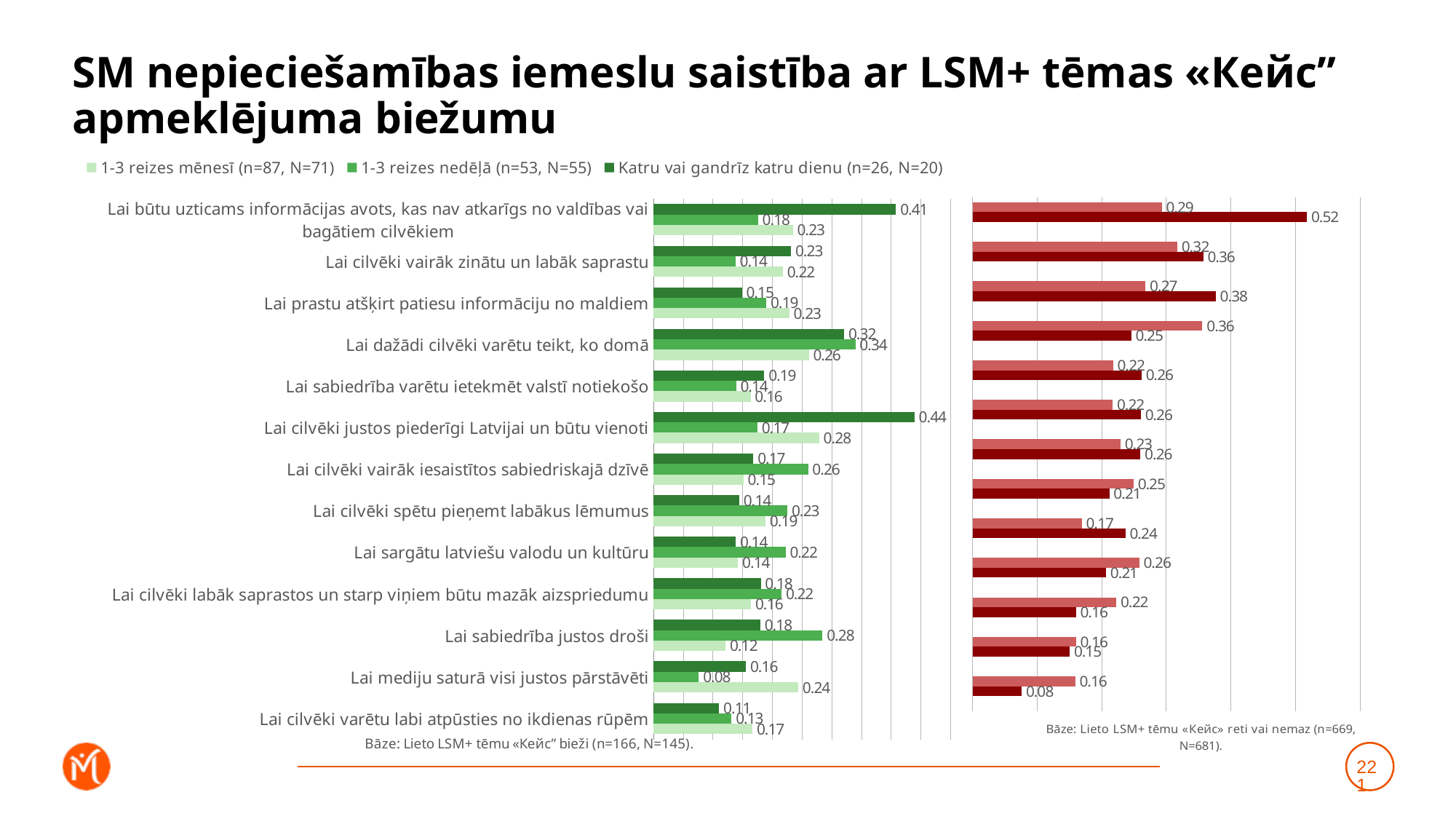
In the left chart, for 'Lai sabiedrība justos droši', which is larger: the '1-3 reizes nedēļā' value or the '1-3 reizes mēnesī' value? 1-3 reizes nedēļā In the left chart, what is the value for 'Katru vai gandrīz katru dienu' for 'Lai cilvēki justos piederīgi Latvijai un būtu vienoti'? 0.44 In the left chart, which category has the lowest value for the '1-3 reizes nedēļā' series? Lai mediju saturā visi justos pārstāvēti How many categories are shown in the left chart? 13 In the left chart, what is the value for '1-3 reizes mēnesī' for 'Lai mediju saturā visi justos pārstāvēti'? 0.24 How many series does the legend of the left chart list? 3 What kind of chart is the left chart? Bar chart In the left chart, for 'Lai būtu uzticams informācijas avots, kas nav atkarīgs no valdības vai bagātiem cilvēkiem', what is the difference between the 'Katru vai gandrīz katru dienu' value and the '1-3 reizes nedēļā' value? 0.23 In the right chart, which category has the highest darker red bar value? Lai būtu uzticams informācijas avots, kas nav atkarīgs no valdības vai bagātiem cilvēkiem In the left chart, which category has the highest value for the 'Katru vai gandrīz katru dienu' series? Lai cilvēki justos piederīgi Latvijai un būtu vienoti In the right chart, what is the value of the darker red bar for 'Lai būtu uzticams informācijas avots, kas nav atkarīgs no valdības vai bagātiem cilvēkiem'? 0.52 In the right chart, for 'Lai dažādi cilvēki varētu teikt, ko domā', what is the difference between the lighter red bar and the darker red bar? 0.11